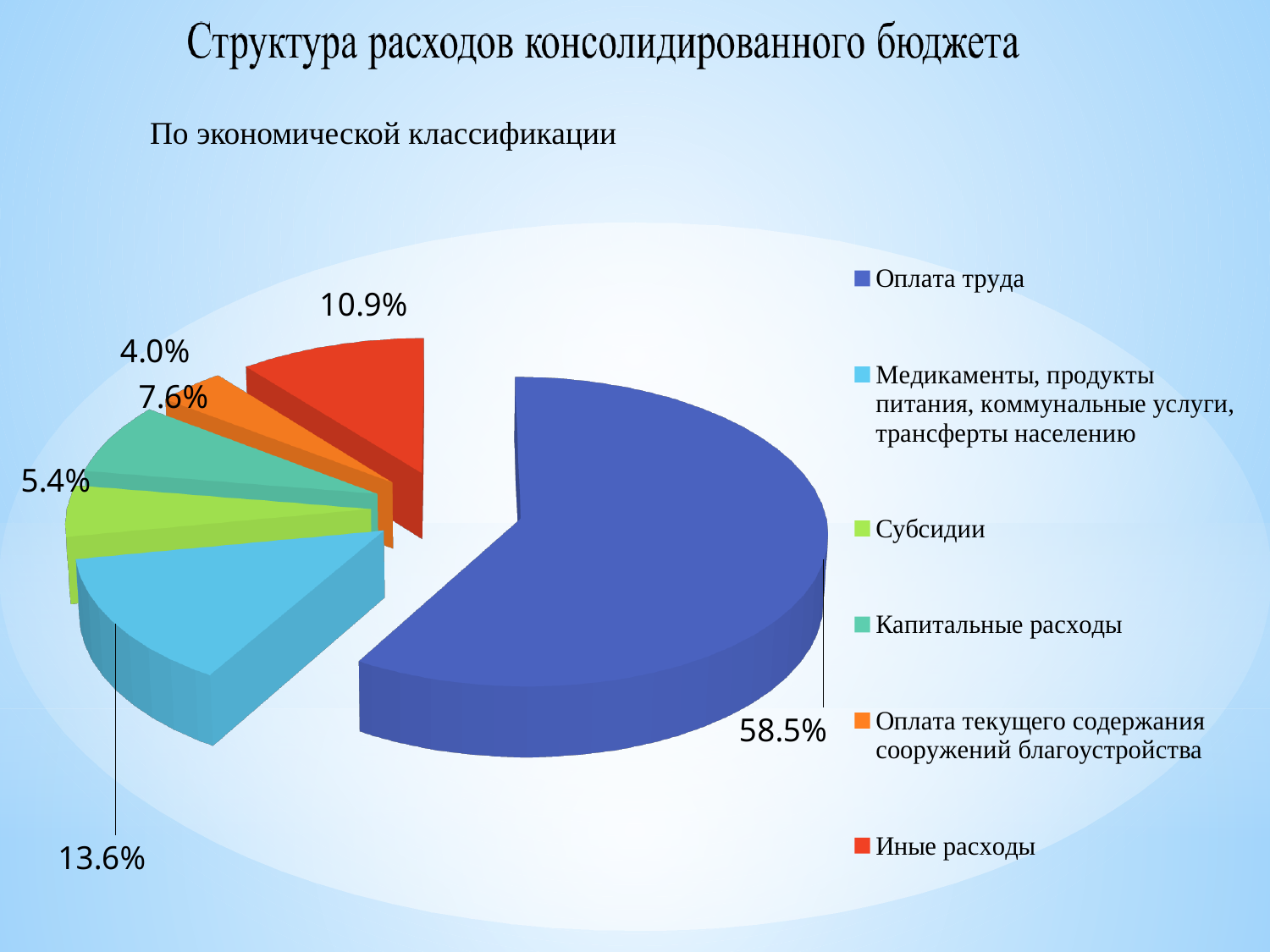
What share of the pie does Оплата труда take? 58.5% How many categories does the pie chart have? 6 What type of chart is shown on the slide? pie chart What is the difference between the share for Оплата труда and the share for Медикаменты, продукты питания, коммунальные услуги, трансферты населению? 44.9% What is the value for Капитальные расходы? 7.6% What colour is the slice for Субсидии? green What is the value for Иные расходы? 10.9% What is the value for Субсидии? 5.4% Which category has the largest slice of the pie? Оплата труда What is the value for Оплата текущего содержания сооружений благоустройства? 4.0% Which is larger: the share for Иные расходы or the share for Капитальные расходы? Иные расходы Which category has the smallest slice of the pie? Оплата текущего содержания сооружений благоустройства